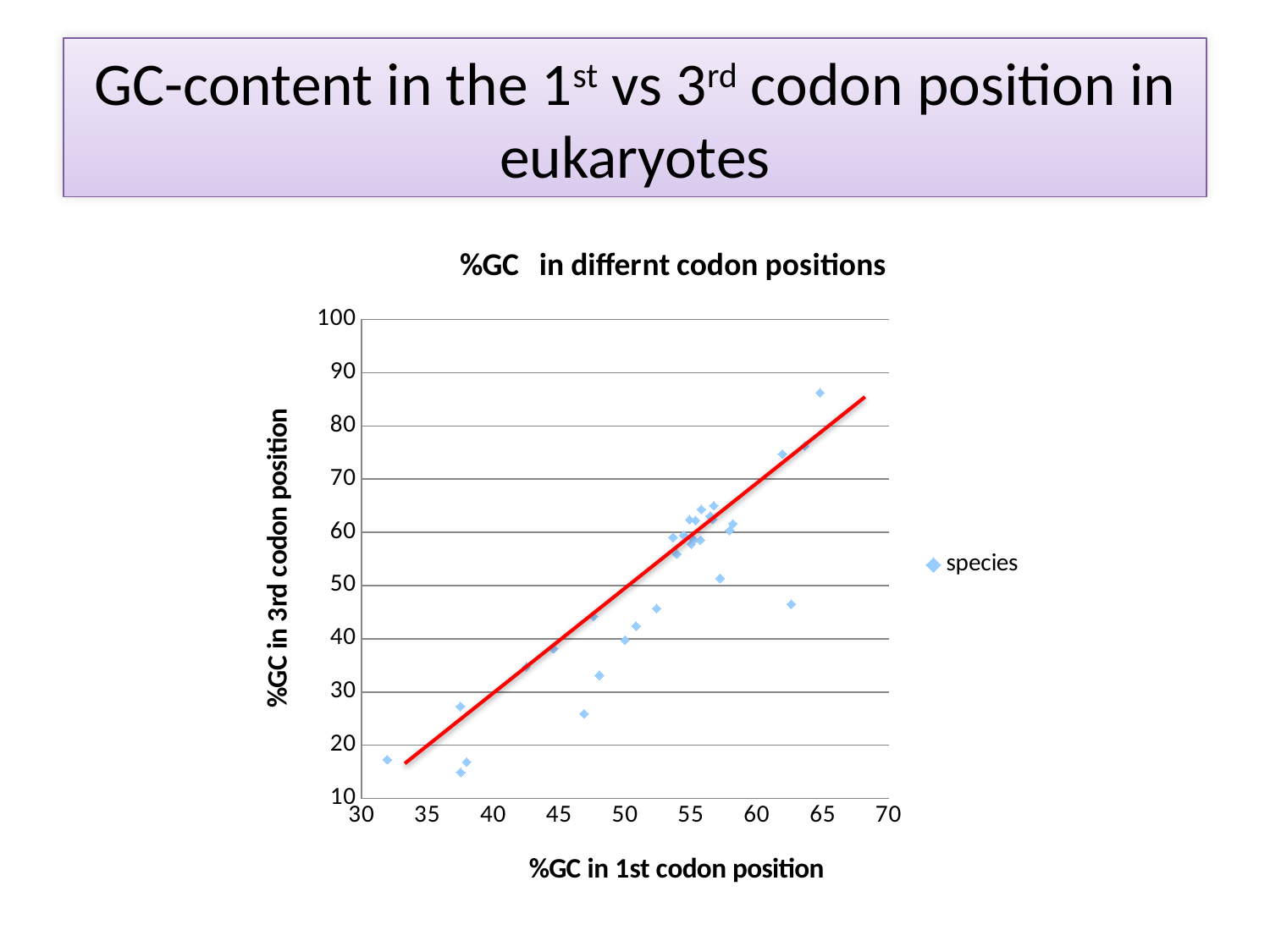
What is the title of the chart? %GC in differnt codon positions Is the %GC in 1st codon position for the leftmost point greater or less than 35? less What kind of chart is shown on the slide? scatter chart Is the %GC in 1st codon position for the rightmost point greater or less than 60? greater Is the %GC in 3rd codon position for the lowest point on the chart greater or less than 20? less What is the name of the series shown in the legend? species How many series does the legend list? 1 As %GC in 1st codon position increases along the x axis, do the values of %GC in 3rd codon position generally rise or fall? rise